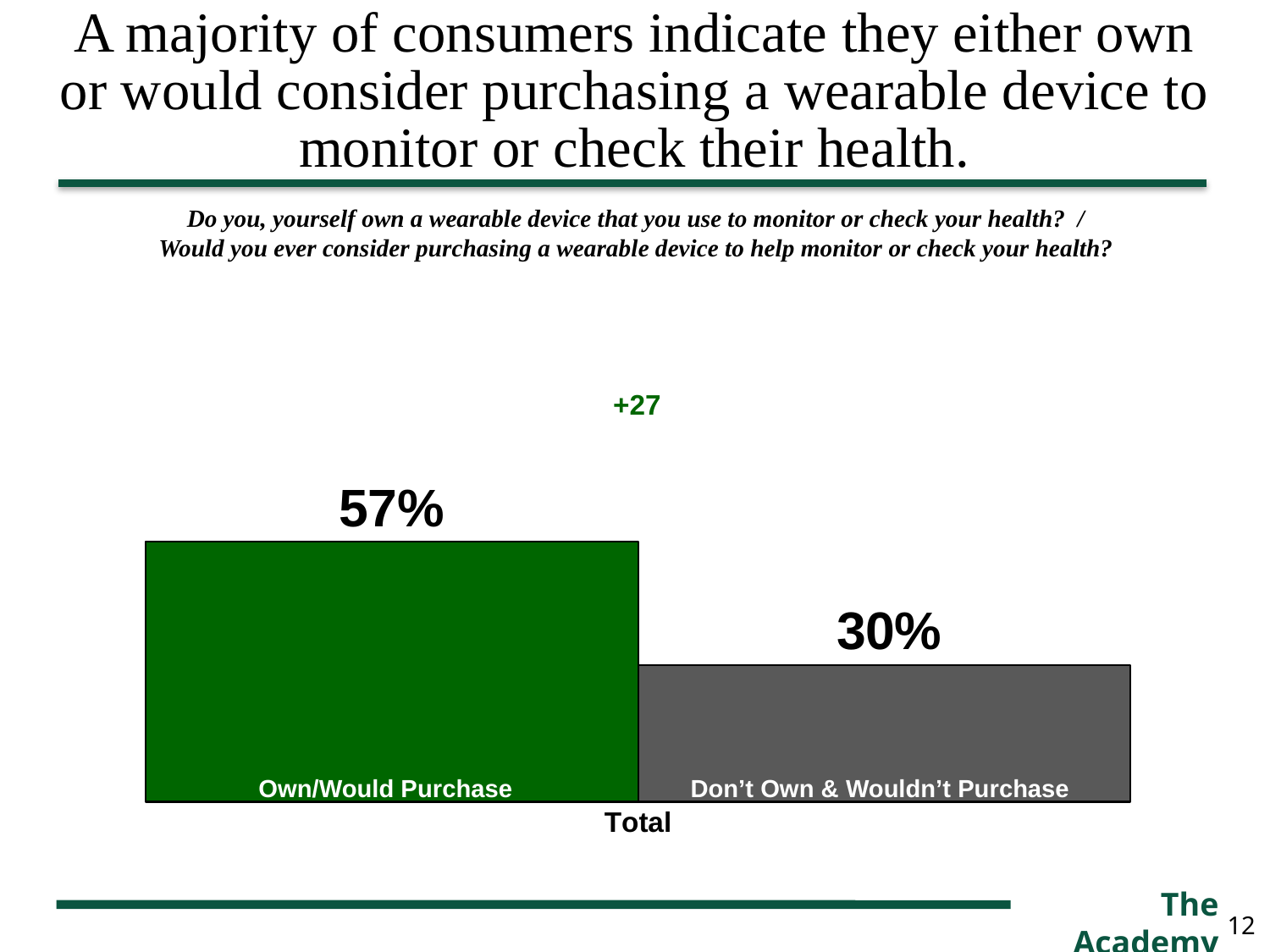
How many categories are shown in the chart? 2 What kind of chart is shown on the slide? bar chart Is the value for Own/Would Purchase larger or smaller than the value for Don't Own & Wouldn't Purchase? larger What percentage of consumers Own/Would Purchase a wearable device? 57% Which category has the lower value? Don't Own & Wouldn't Purchase Which category has the higher value, Own/Would Purchase or Don't Own & Wouldn't Purchase? Own/Would Purchase What number is printed above the bars to show the gap between the two categories? +27 What is the label on the x axis beneath the bars? Total What percentage of consumers Don't Own & Wouldn't Purchase a wearable device? 30% What is the difference in percentage points between Own/Would Purchase and Don't Own & Wouldn't Purchase? 27 What colour is the bar for Own/Would Purchase? green